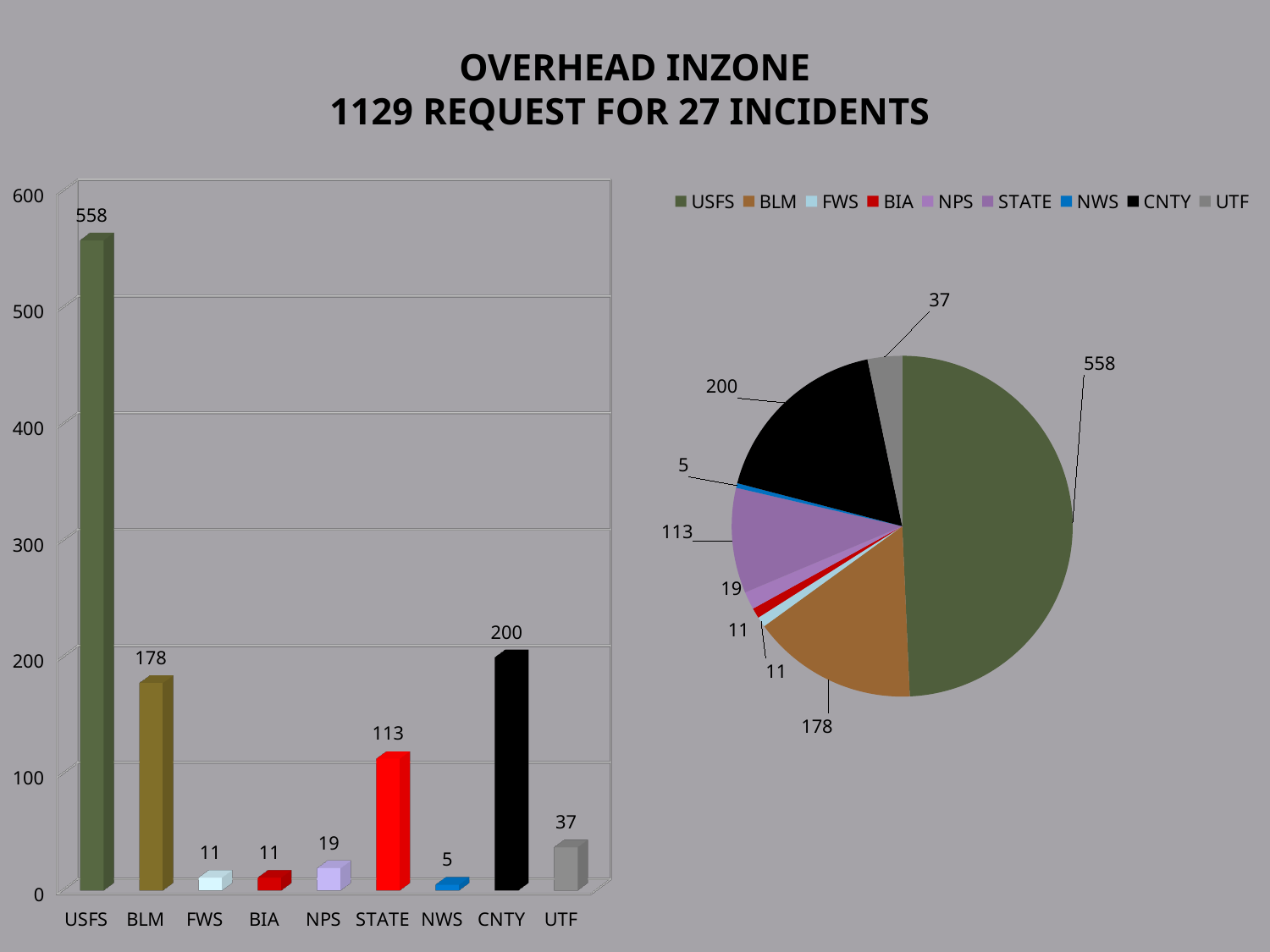
In the pie chart on the right, how many entries does the legend list? 9 What kind of chart is on the left side of the slide? Bar chart In the bar chart on the left, what is the value for USFS? 558 In the bar chart on the left, which category has the lowest value? NWS In the bar chart on the left, what is the difference between the values for USFS and BLM? 380 In the bar chart on the left, how many categories are shown on the x axis? 9 In the bar chart on the left, what is the value for CNTY? 200 In the bar chart on the left, which is larger, the value for CNTY or the value for BLM? CNTY In the bar chart on the left, which category has the highest value? USFS What kind of chart is on the right side of the slide? Pie chart In the bar chart on the left, what is the value for STATE? 113 In the pie chart on the right, what is the value labelled for the UTF slice? 37